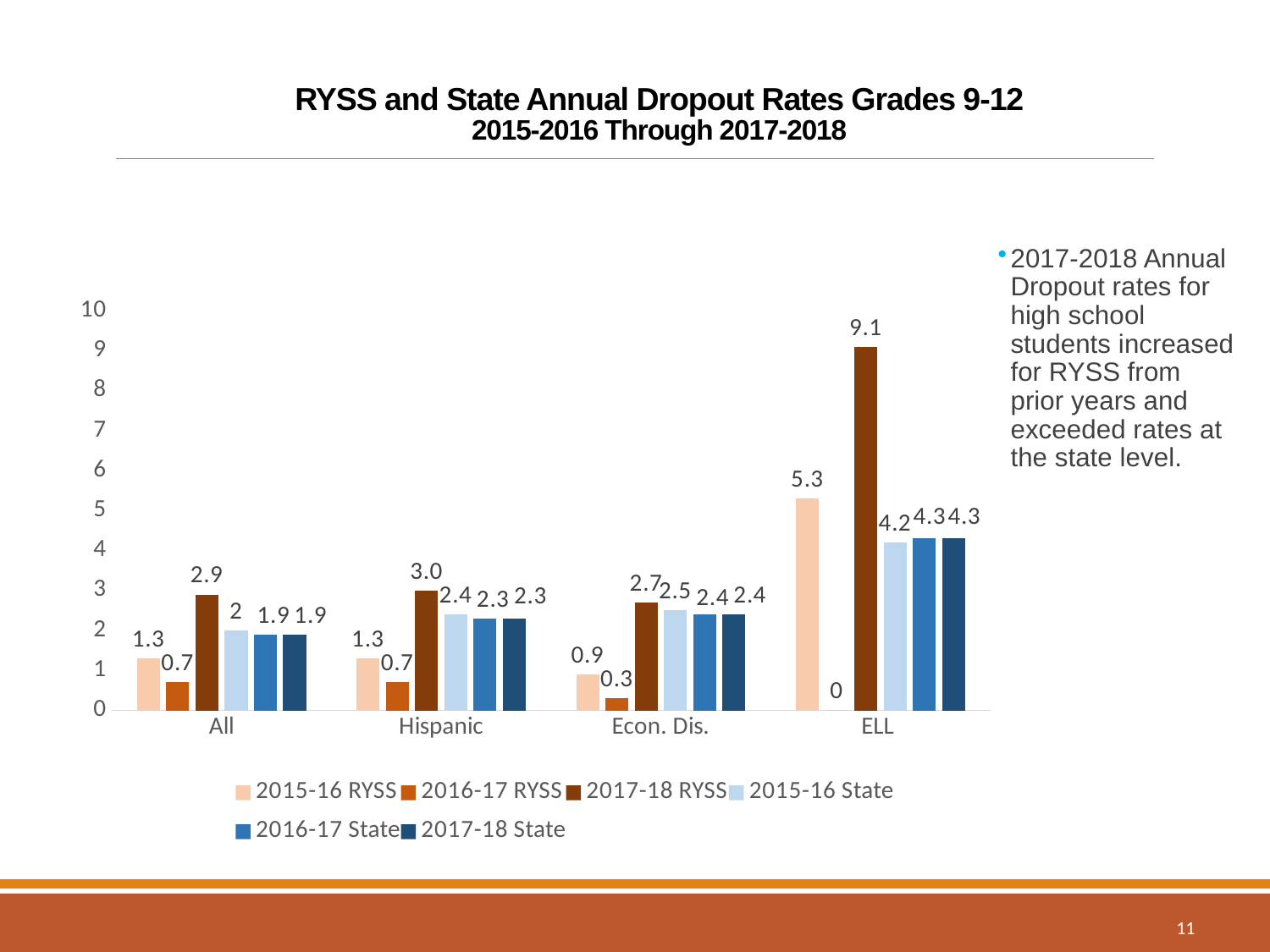
Which category has the lowest 2016-17 RYSS dropout rate? ELL What kind of chart is shown on the slide? Bar chart What is the difference between the 2017-18 RYSS and 2017-18 State dropout rates for ELL students? 4.8 What is the title of the chart? RYSS and State Annual Dropout Rates Grades 9-12 2015-2016 Through 2017-2018 Which is larger for the All category: the 2017-18 RYSS rate or the 2017-18 State rate? 2017-18 RYSS Is the 2015-16 RYSS dropout rate for ELL students greater or less than 5? greater What is the 2015-16 State dropout rate for Hispanic students? 2.4 How many series does the legend list? 6 What is the 2016-17 RYSS dropout rate for the Econ. Dis. category? 0.3 What is the 2017-18 RYSS dropout rate for ELL students? 9.1 How many student categories are shown on the x axis? 4 Which category has the highest 2017-18 RYSS dropout rate? ELL